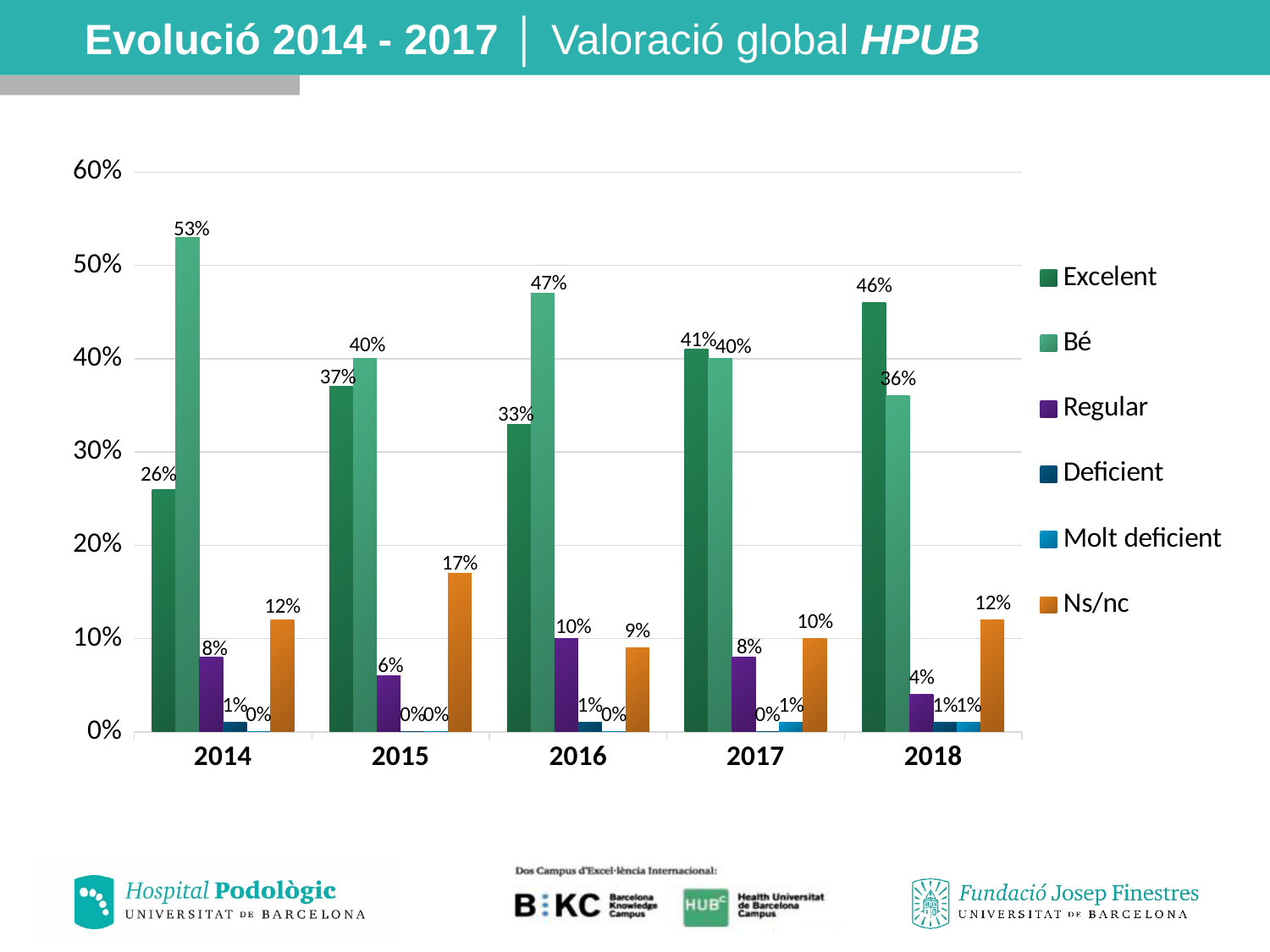
Does the Excelent value rise or fall from 2016 to 2018? Rise How many series does the legend list? 6 What is the value for Bé in 2014? 53% What is the value for Regular in 2016? 10% In which year is the Excelent value highest? 2018 How many years are shown on the x axis? 5 What is the value for Excelent in 2018? 46% In which year is the Bé value lowest? 2018 Which is larger in 2017, Excelent or Bé? Excelent What kind of chart is shown on the slide? Bar chart What is the difference between the Bé and Excelent values in 2014? 27% What is the value for Ns/nc in 2015? 17%